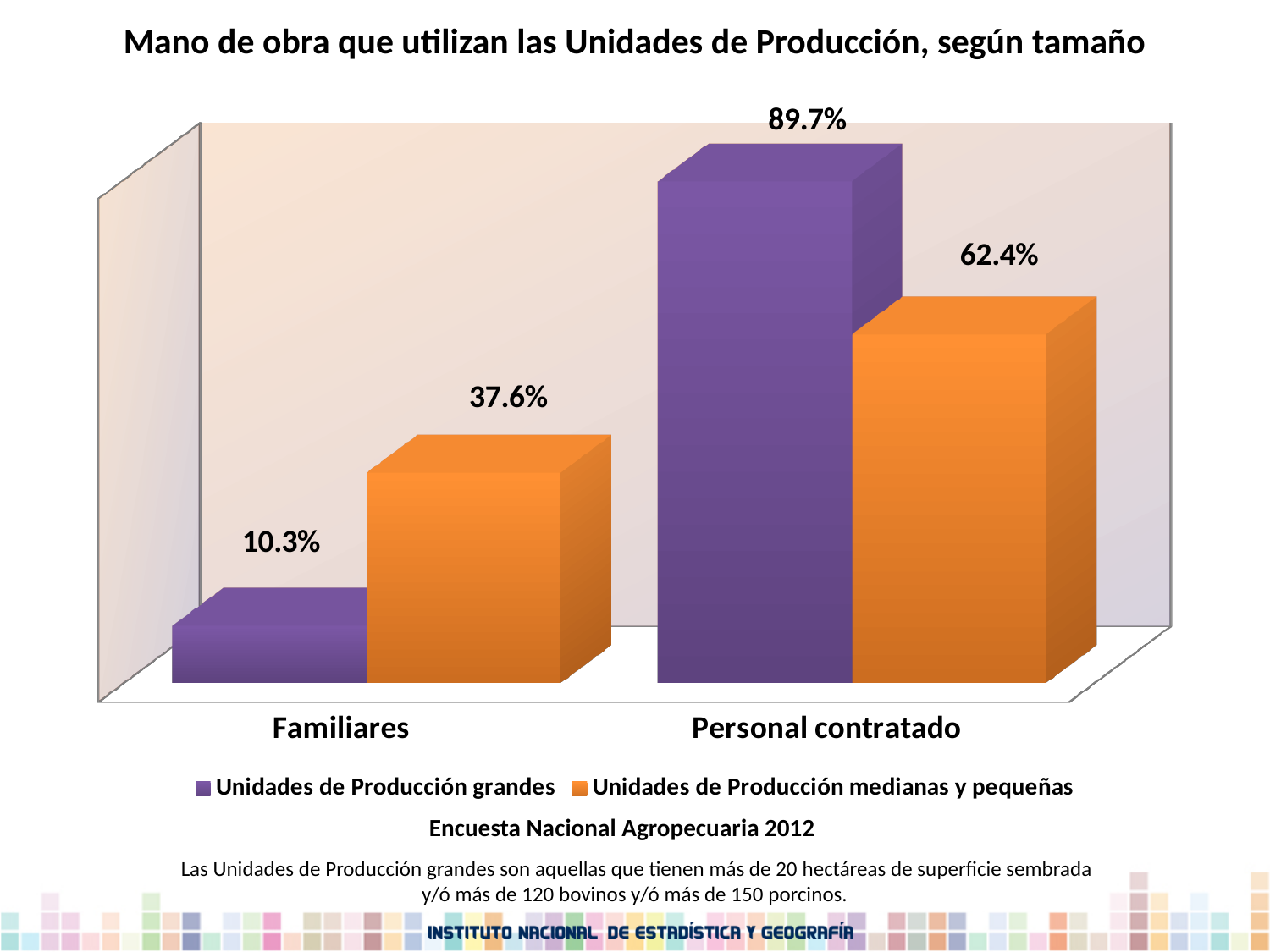
What is the value for Unidades de Producción grandes in the Personal contratado category? 89.7% Which bar has the lowest value on the chart? Unidades de Producción grandes, Familiares What is the difference between the two series in the Personal contratado category? 27.3% What is the difference between the two series in the Familiares category? 27.3% In the Familiares category, which series has the larger value? Unidades de Producción medianas y pequeñas What is the value for Unidades de Producción medianas y pequeñas in the Familiares category? 37.6% How many categories are shown on the x axis? 2 What kind of chart is shown on the slide? Bar chart Which bar has the highest value on the chart? Unidades de Producción grandes, Personal contratado What is the value for Unidades de Producción medianas y pequeñas in the Personal contratado category? 62.4% What is the value for Unidades de Producción grandes in the Familiares category? 10.3% How many series does the legend list? 2